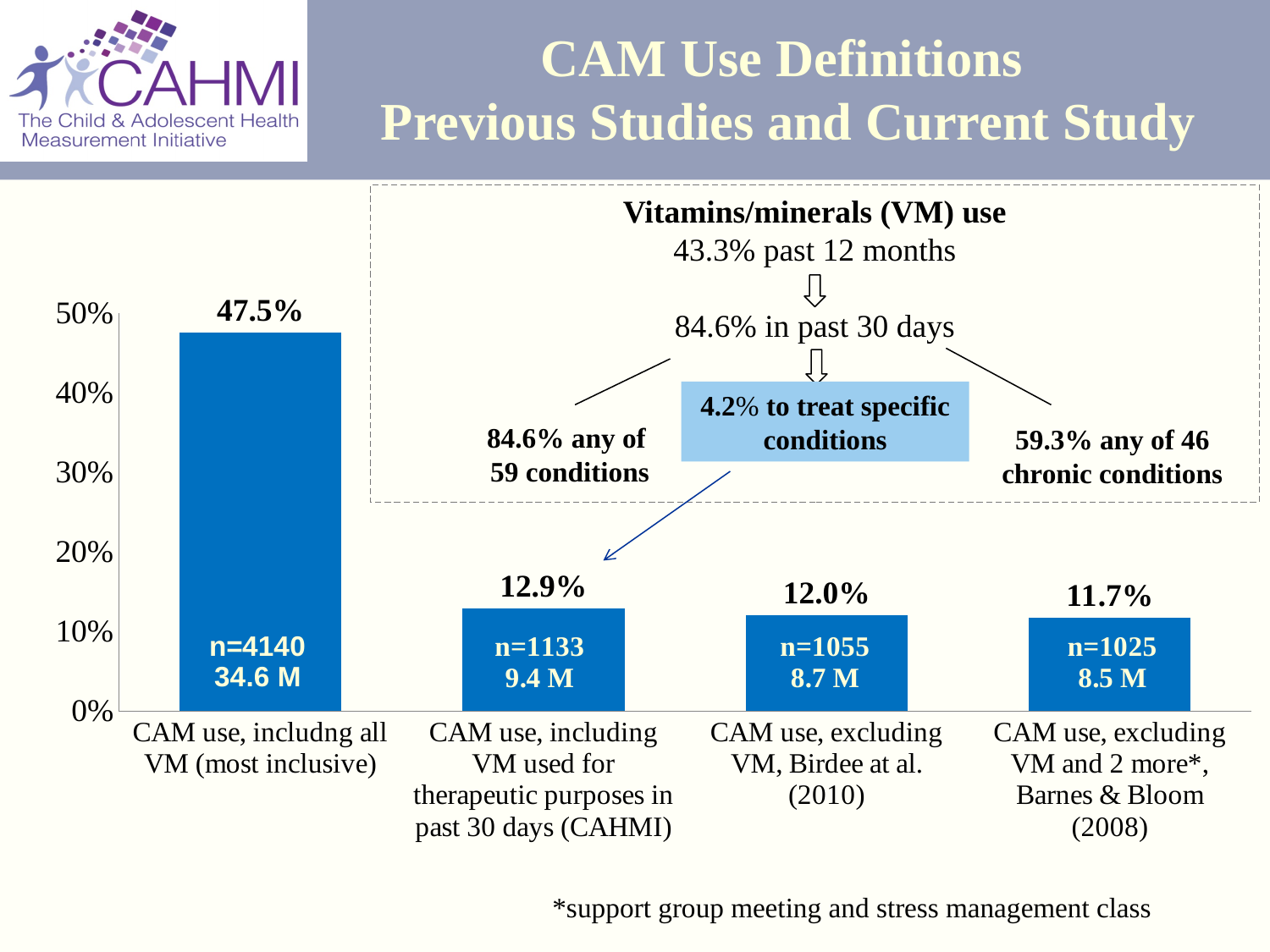
What is the difference between the value for 'CAM use, includng all VM (most inclusive)' and the value for 'CAM use, including VM used for therapeutic purposes in past 30 days (CAHMI)'? 34.6% What kind of chart is shown on the slide? bar chart What is the value for 'CAM use, includng all VM (most inclusive)'? 47.5% What is the value for 'CAM use, including VM used for therapeutic purposes in past 30 days (CAHMI)'? 12.9% What is the value for 'CAM use, excluding VM and 2 more*, Barnes & Bloom (2008)'? 11.7% What sample size (n) is printed on the bar for 'CAM use, excluding VM, Birdee at al. (2010)'? n=1055 Which category has the lowest value? CAM use, excluding VM and 2 more*, Barnes & Bloom (2008) What is the difference between the value for 'CAM use, excluding VM, Birdee at al. (2010)' and the value for 'CAM use, excluding VM and 2 more*, Barnes & Bloom (2008)'? 0.3% Which is larger: the value for 'CAM use, including VM used for therapeutic purposes in past 30 days (CAHMI)' or the value for 'CAM use, excluding VM, Birdee at al. (2010)'? CAM use, including VM used for therapeutic purposes in past 30 days (CAHMI) Which category has the highest value? CAM use, includng all VM (most inclusive) How many categories are shown in the bar chart? 4 What is the value for 'CAM use, excluding VM, Birdee at al. (2010)'? 12.0%